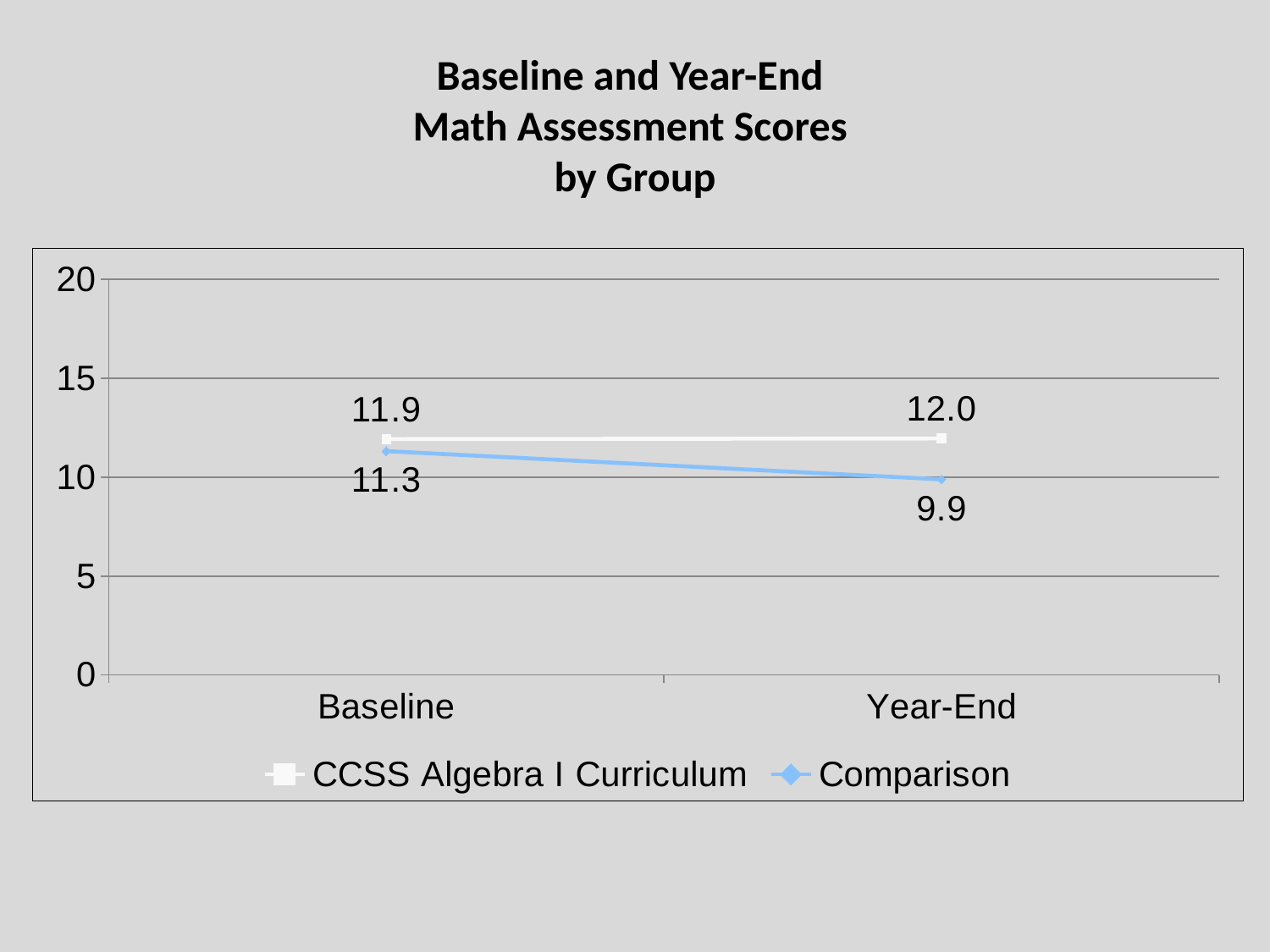
How many series does the legend list? 2 What is the Year-End score for the CCSS Algebra I Curriculum group? 12.0 Which group has the higher Year-End score? CCSS Algebra I Curriculum What is the Year-End score for the Comparison group? 9.9 Does the CCSS Algebra I Curriculum group's score rise or fall from Baseline to Year-End? rise What is the difference between the Baseline and Year-End scores for the Comparison group? 1.4 What is the Baseline score for the Comparison group? 11.3 What is the difference between the Year-End scores of the CCSS Algebra I Curriculum group and the Comparison group? 2.1 What is the Baseline score for the CCSS Algebra I Curriculum group? 11.9 What is the title of the chart? Baseline and Year-End Math Assessment Scores by Group Does the Comparison group's score rise or fall from Baseline to Year-End? fall What kind of chart is shown on the slide? line chart